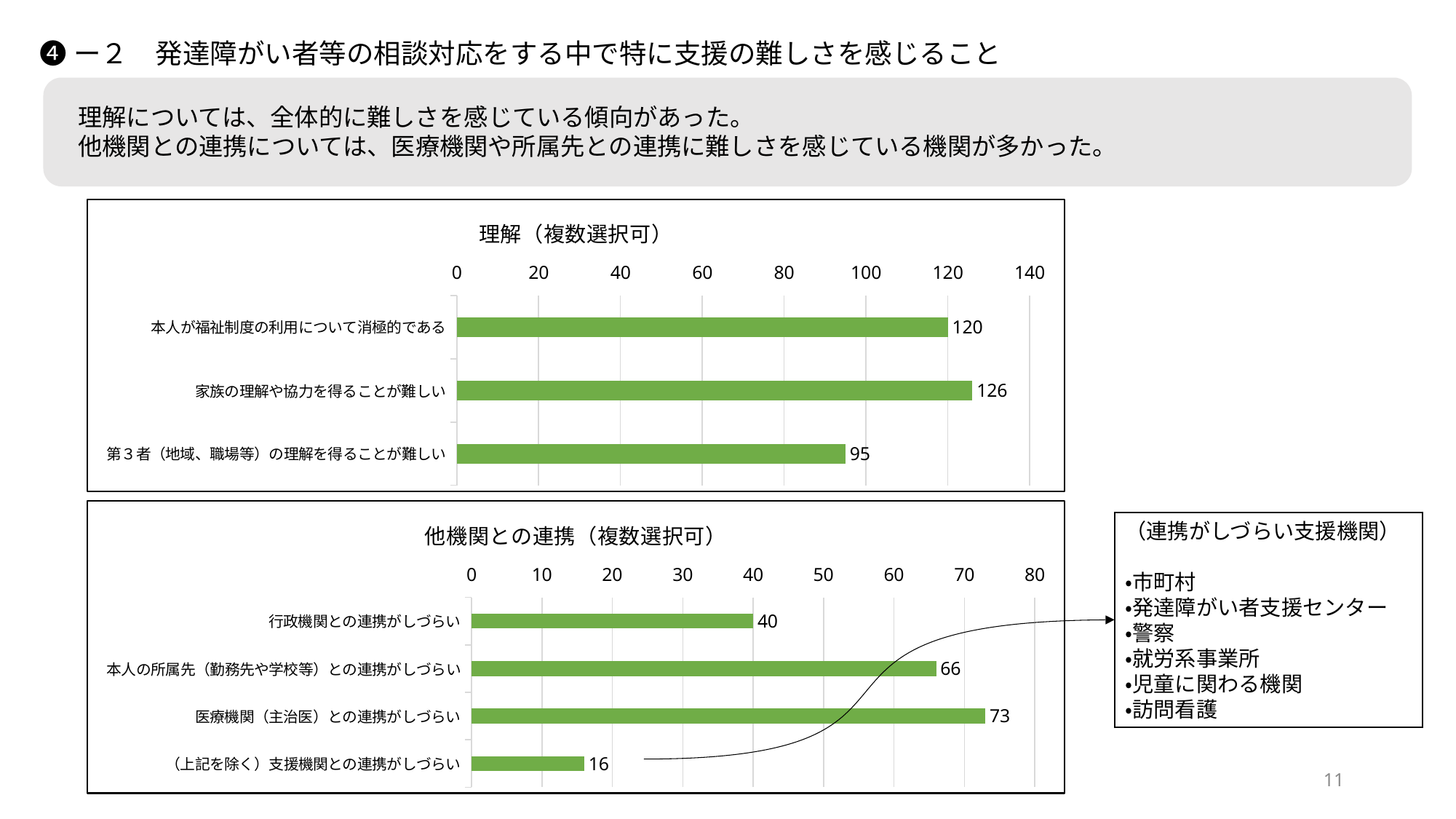
In the chart titled 理解（複数選択可）, what is the difference between the values for 家族の理解や協力を得ることが難しい and 第３者（地域、職場等）の理解を得ることが難しい? 31 In the chart titled 他機関との連携（複数選択可）, what is the value for （上記を除く）支援機関との連携がしづらい? 16 In the chart titled 他機関との連携（複数選択可）, what is the difference between the values for 医療機関（主治医）との連携がしづらい and 行政機関との連携がしづらい? 33 In the chart titled 他機関との連携（複数選択可）, which is larger: the value for 行政機関との連携がしづらい or the value for 本人の所属先（勤務先や学校等）との連携がしづらい? 本人の所属先（勤務先や学校等）との連携がしづらい In the chart titled 他機関との連携（複数選択可）, how many categories are plotted? 4 In the chart titled 理解（複数選択可）, what is the value for 本人が福祉制度の利用について消極的である? 120 In the chart titled 理解（複数選択可）, how many categories are plotted? 3 In the chart titled 他機関との連携（複数選択可）, which category has the lowest value? （上記を除く）支援機関との連携がしづらい In the chart titled 理解（複数選択可）, which category has the highest value? 家族の理解や協力を得ることが難しい In the chart titled 理解（複数選択可）, which category has the lowest value? 第３者（地域、職場等）の理解を得ることが難しい What type of chart is the chart titled 他機関との連携（複数選択可）? Bar chart In the chart titled 他機関との連携（複数選択可）, what is the value for 医療機関（主治医）との連携がしづらい? 73